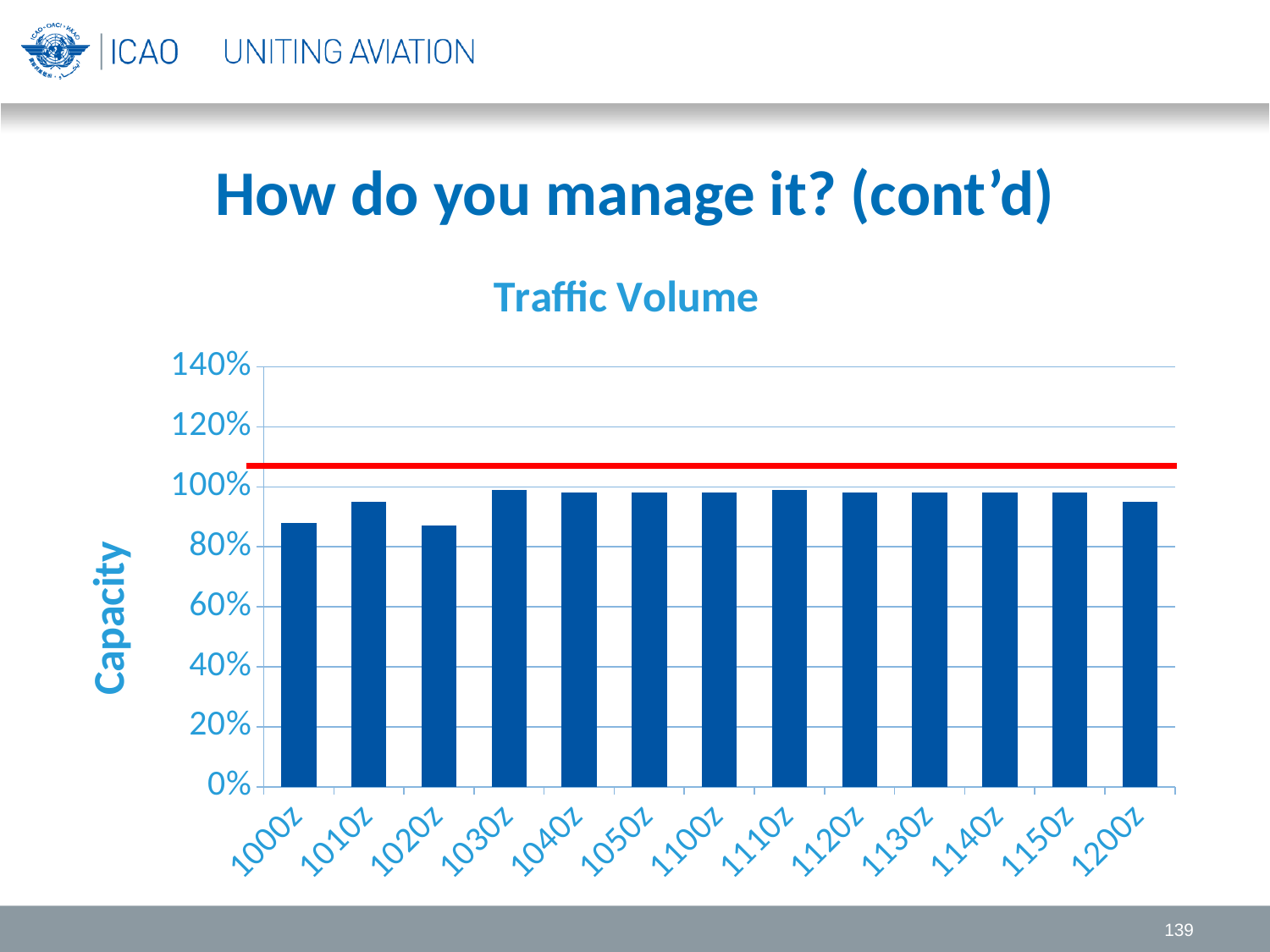
What kind of chart is shown on the slide? bar chart Is the value for 1000Z greater or less than 100%? less What is the title of the chart? Traffic Volume Is the value for 1020Z greater or less than 100%? less How many time categories are shown on the x axis of the chart? 13 Is the value for 1030Z greater or less than 80%? greater What is the label of the vertical axis? Capacity Which has the larger value, 1000Z or 1010Z? 1010Z What is the first time category on the x axis? 1000z Which has the larger value, 1020Z or 1030Z? 1030Z